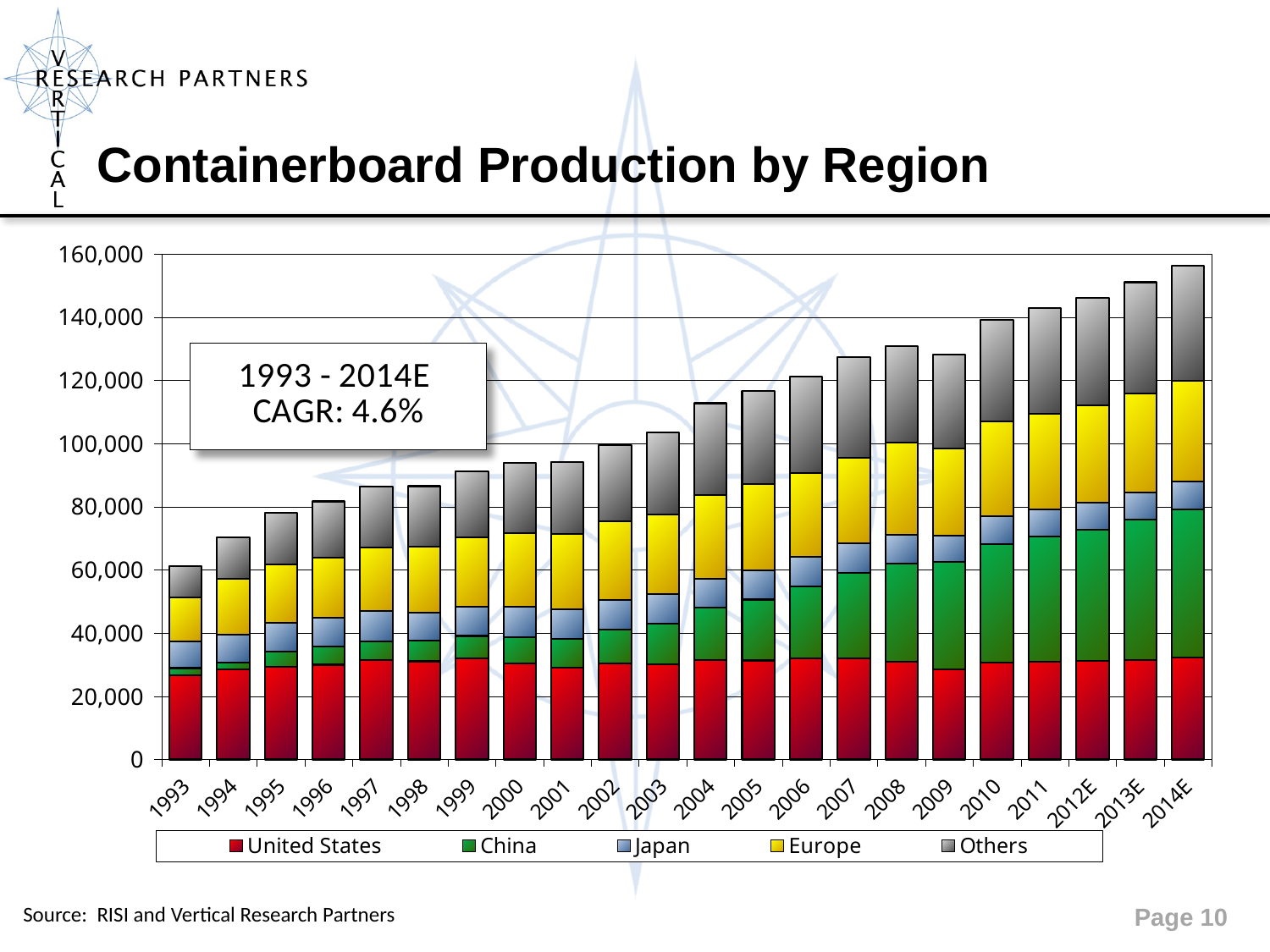
Do total production values generally rise or fall from 1993 to 2014E? rise What CAGR is stated in the annotation box on the chart for 1993 - 2014E? 4.6% Is the total production for 2004 greater or less than 100,000? greater Which year has the lowest total containerboard production? 1993 Is the total production for 2007 greater or less than 120,000? greater What kind of chart is shown on the slide? Stacked bar chart How many series does the legend list? 5 How many years (categories) are shown along the x axis? 22 Which year has the larger total production, 1993 or 2014E? 2014E Which year has the highest total containerboard production? 2014E Is the total production for 2014E greater or less than 140,000? greater